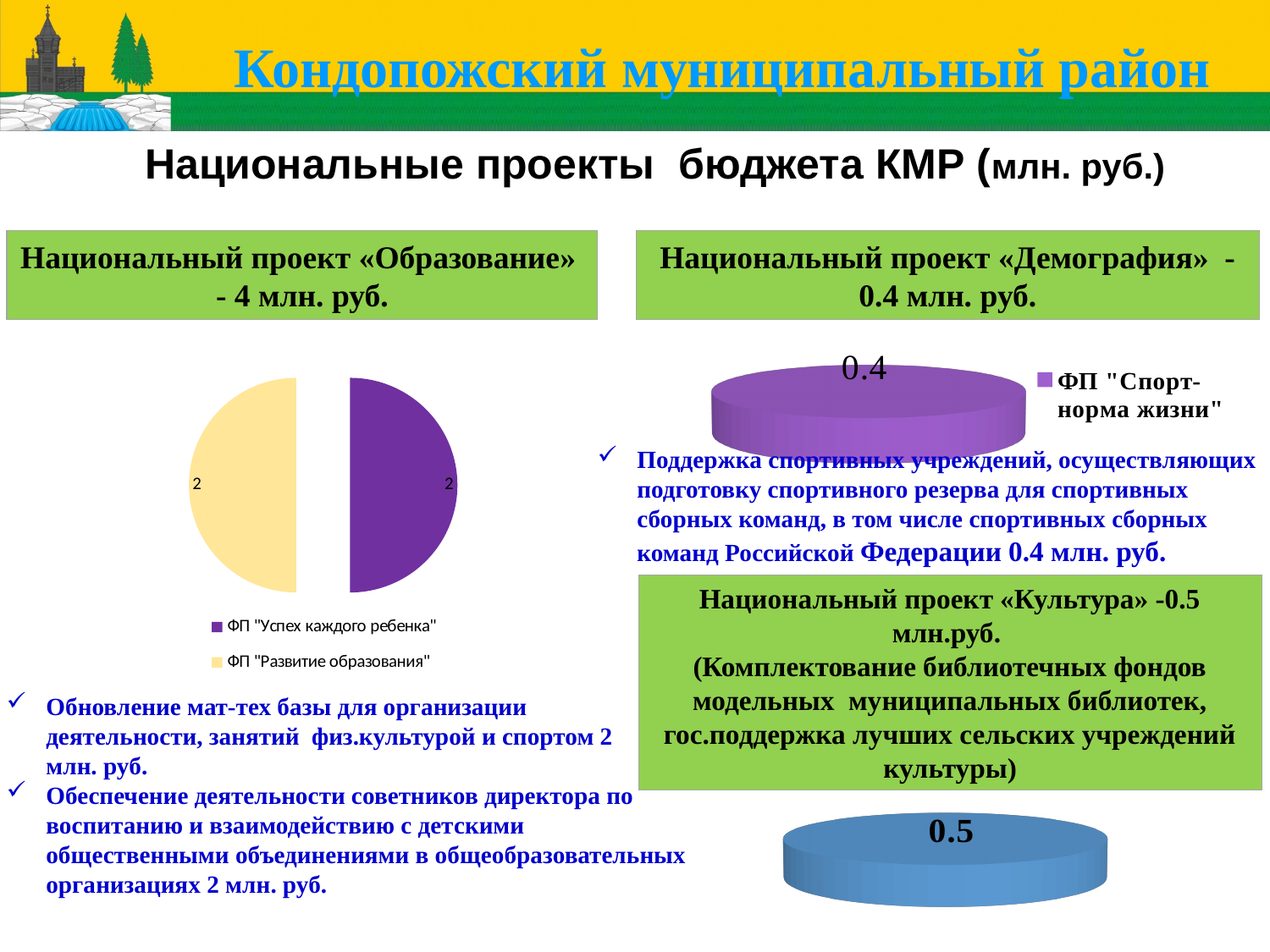
On the pie chart under «Национальный проект «Образование»», how many entries does the legend list? 2 On the pie chart under «Национальный проект «Образование»», which legend entry is shown in purple? ФП "Успех каждого ребенка" On the pie chart under «Национальный проект «Образование»», what is the value for ФП "Развитие образования"? 2 On the pie chart under «Национальный проект «Образование»», how many slices are there? 2 On the chart under «Национальный проект «Демография»», what is the legend entry? ФП "Спорт-норма жизни" On the pie chart under «Национальный проект «Образование»», what is the total of the two slices? 4 On the chart under «Национальный проект «Демография»», what value is printed on the chart? 0.4 On the pie chart under «Национальный проект «Образование»», what is the value for ФП "Успех каждого ребенка"? 2 Which is larger: the value on the «Демография» chart or the value on the «Культура» chart? «Культура» (0.5) On the chart under «Национальный проект «Культура»» at the bottom right, what value is printed on the chart? 0.5 On the pie chart under «Национальный проект «Образование»», what share of the pie does ФП "Успех каждого ребенка" take? 50% What kind of chart is shown under «Национальный проект «Образование»»? Pie chart